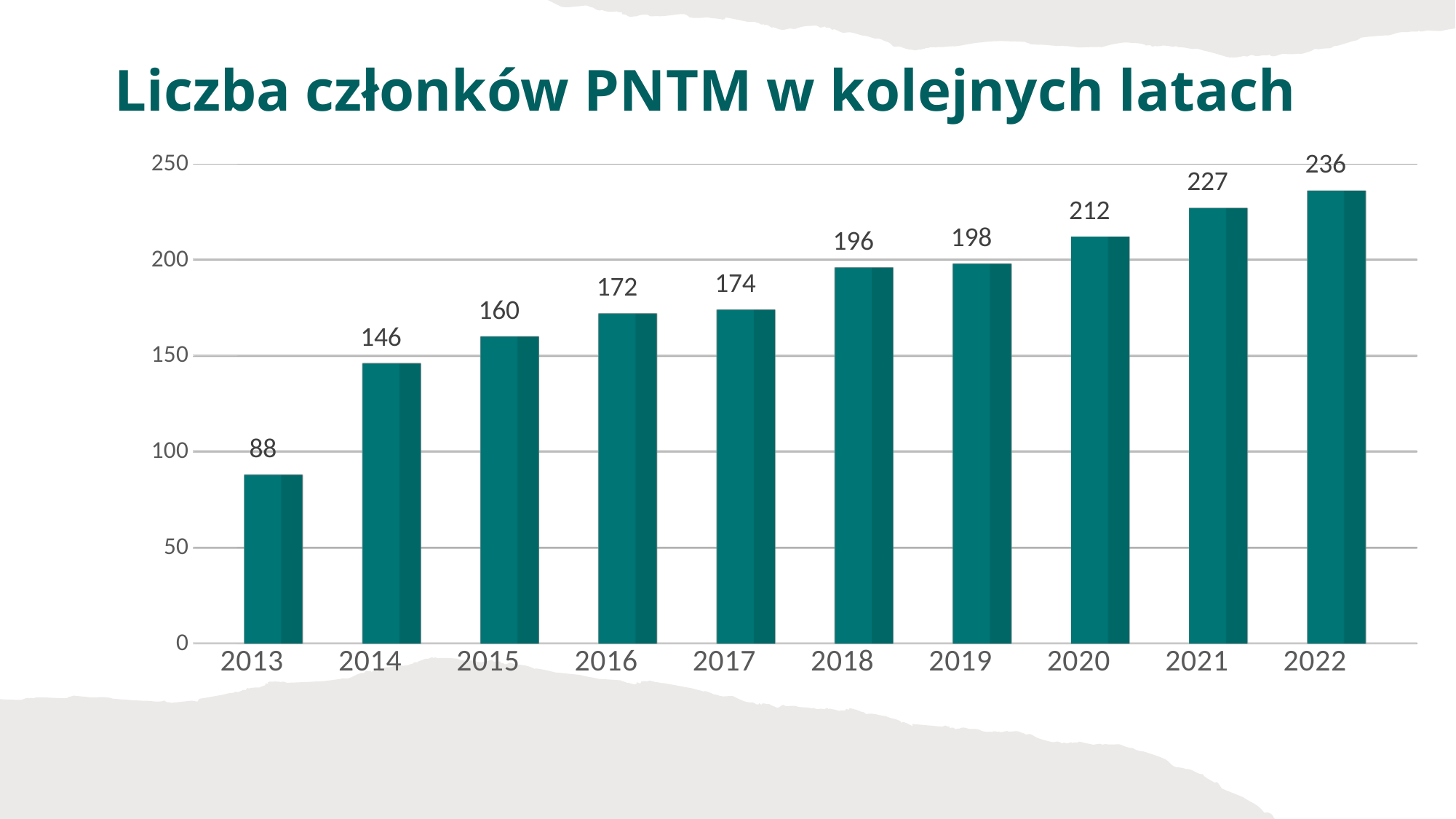
What is the difference between the values for 2014 and 2013? 58 Which year has the highest value? 2022 Which is larger, the value for 2016 or the value for 2020? 2020 Is the value for 2015 greater or less than 150? greater Which year has the lowest value? 2013 What kind of chart is shown on the slide? bar chart What is the value for 2022? 236 What is the value for 2013? 88 What is the difference between the values for 2022 and 2013? 148 How many years are shown on the x axis? 10 What is the value for 2018? 196 Do the values rise or fall from 2013 to 2022? rise